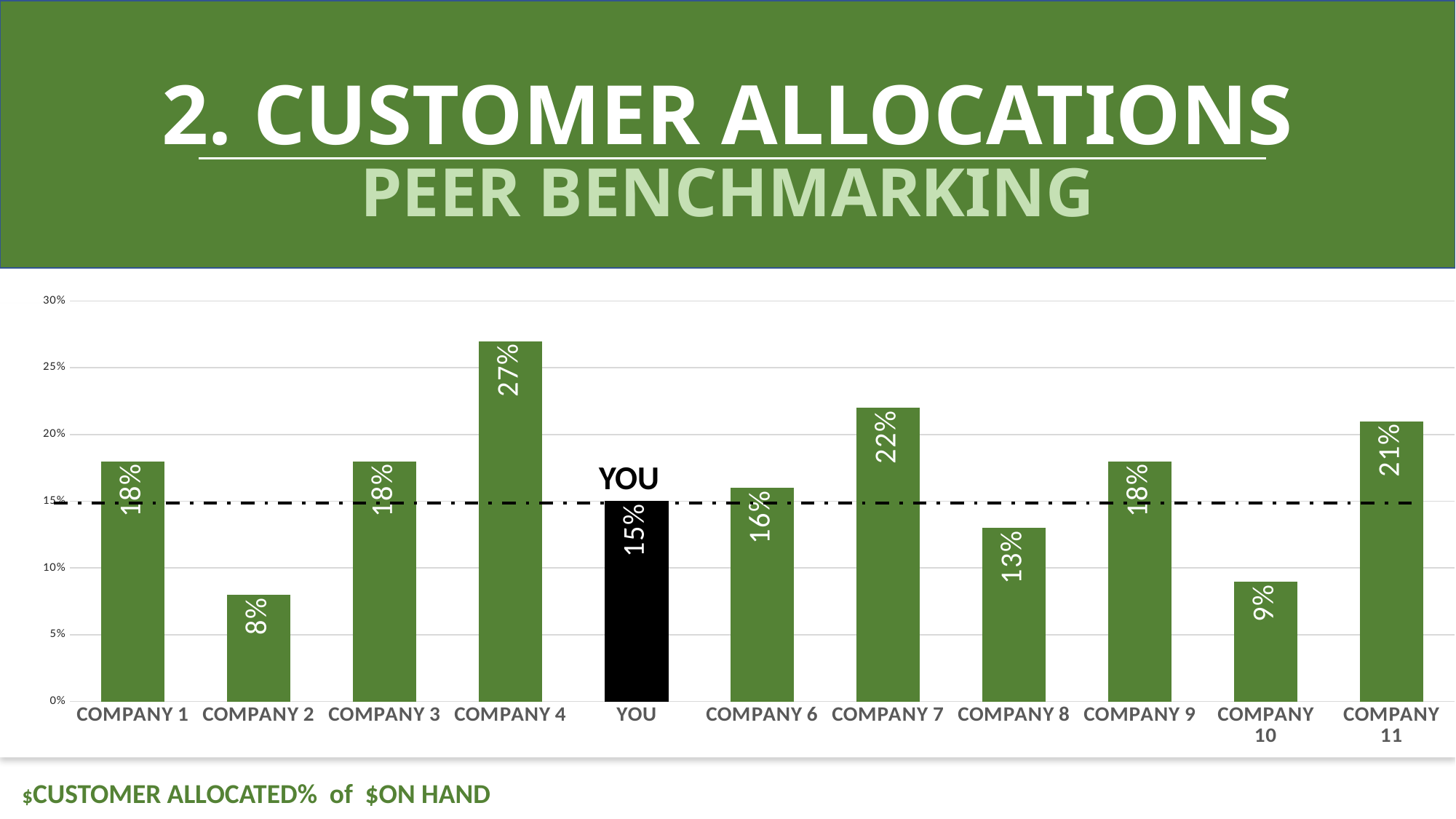
How many bars are shown in the chart? 11 Which category has the highest value? COMPANY 4 What kind of chart is shown on the slide? bar chart What is the value for the bar labelled YOU? 15% What is the difference between the values for COMPANY 7 and COMPANY 8? 9% What is the value for COMPANY 4? 27% What is the subtitle shown below the main title on the slide? PEER BENCHMARKING Which category has the lowest value? COMPANY 2 Which is larger, the value for COMPANY 6 or the value for COMPANY 11? COMPANY 11 What is the value for COMPANY 10? 9% What colour is the bar labelled YOU? black Is the value for COMPANY 9 greater or less than 15%? greater